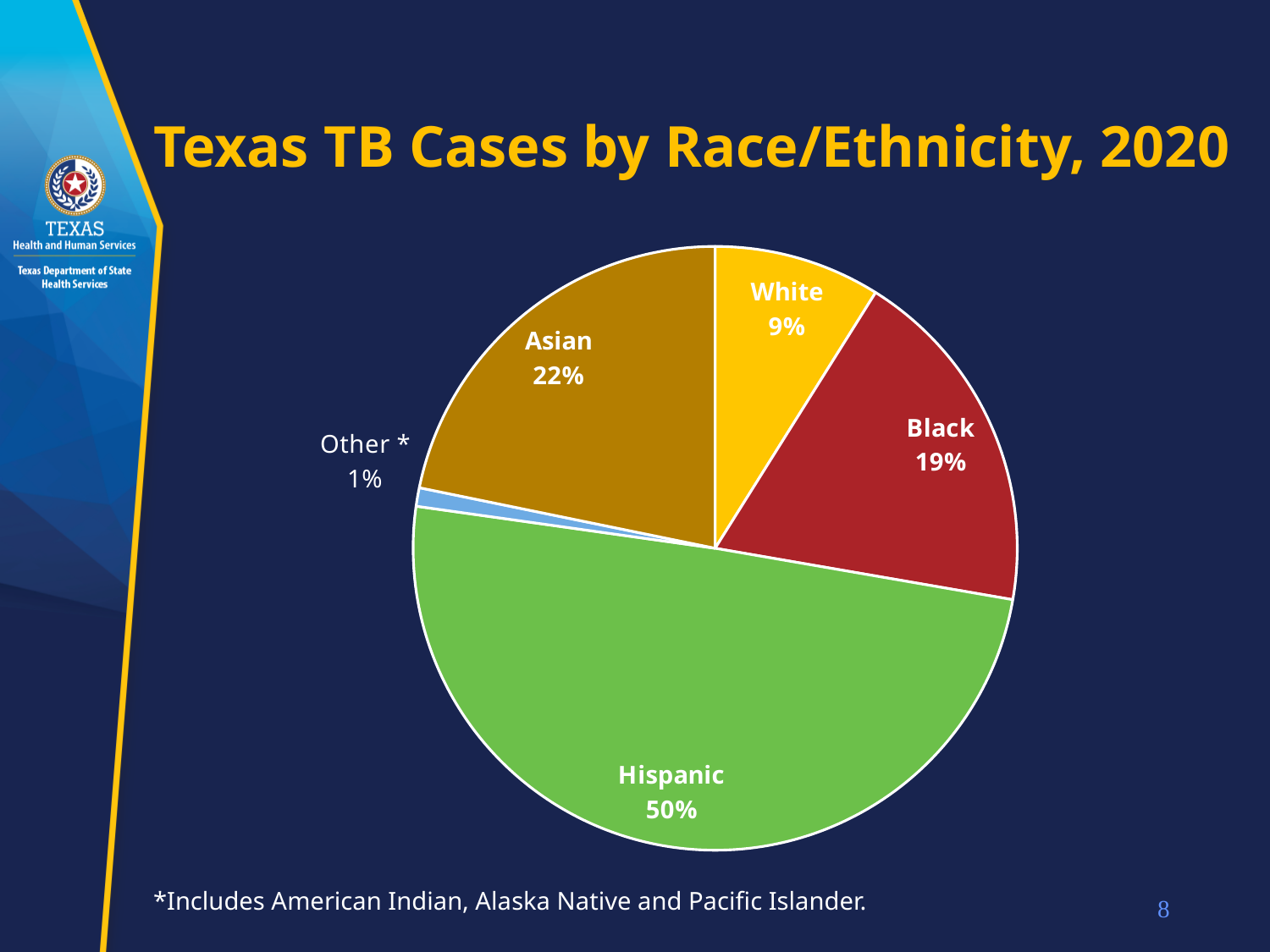
Which is larger, the share for Black or the share for White? Black What share of cases is shown for Black? 19% What percentage of the pie is labelled Asian? 22% Which race/ethnicity has the largest share of TB cases? Hispanic Which race/ethnicity has the smallest share of TB cases? Other * What percentage is shown for the Other * slice? 1% What share of Texas TB cases in 2020 were Hispanic? 50% What is the title of the chart on the slide? Texas TB Cases by Race/Ethnicity, 2020 How many percentage points larger is the Asian share than the Black share? 3 What percentage is shown for the White slice? 9% How many slices does the pie chart have? 5 What kind of chart is shown on the slide? Pie chart